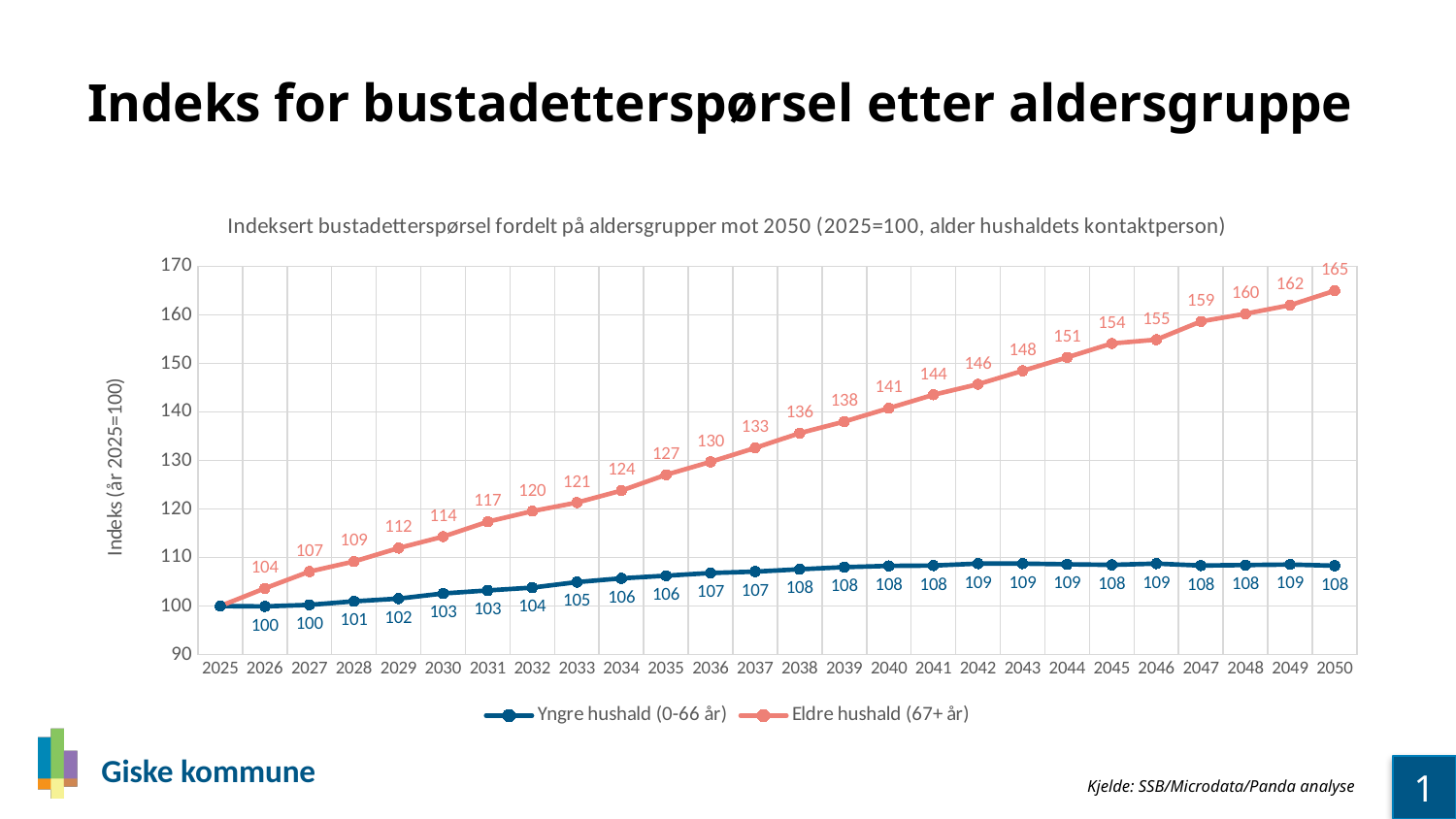
How many years are plotted on the x axis? 26 What is the value for Yngre hushald (0-66 år) in 2030? 103 What is the value for Yngre hushald (0-66 år) in 2040? 108 What is the value for Eldre hushald (67+ år) in 2050? 165 In which year does Eldre hushald (67+ år) reach its highest value? 2050 Does the Eldre hushald (67+ år) series rise or fall from 2025 to 2050? Rise What kind of chart is shown on the slide? Line chart How many series does the legend list? 2 Which series has the larger value in 2045, Yngre hushald (0-66 år) or Eldre hushald (67+ år)? Eldre hushald (67+ år) What is the value for Eldre hushald (67+ år) in 2035? 127 What is the difference between the Eldre hushald (67+ år) values in 2040 and 2030? 27 What is the difference between Eldre hushald (67+ år) and Yngre hushald (0-66 år) in 2050? 57